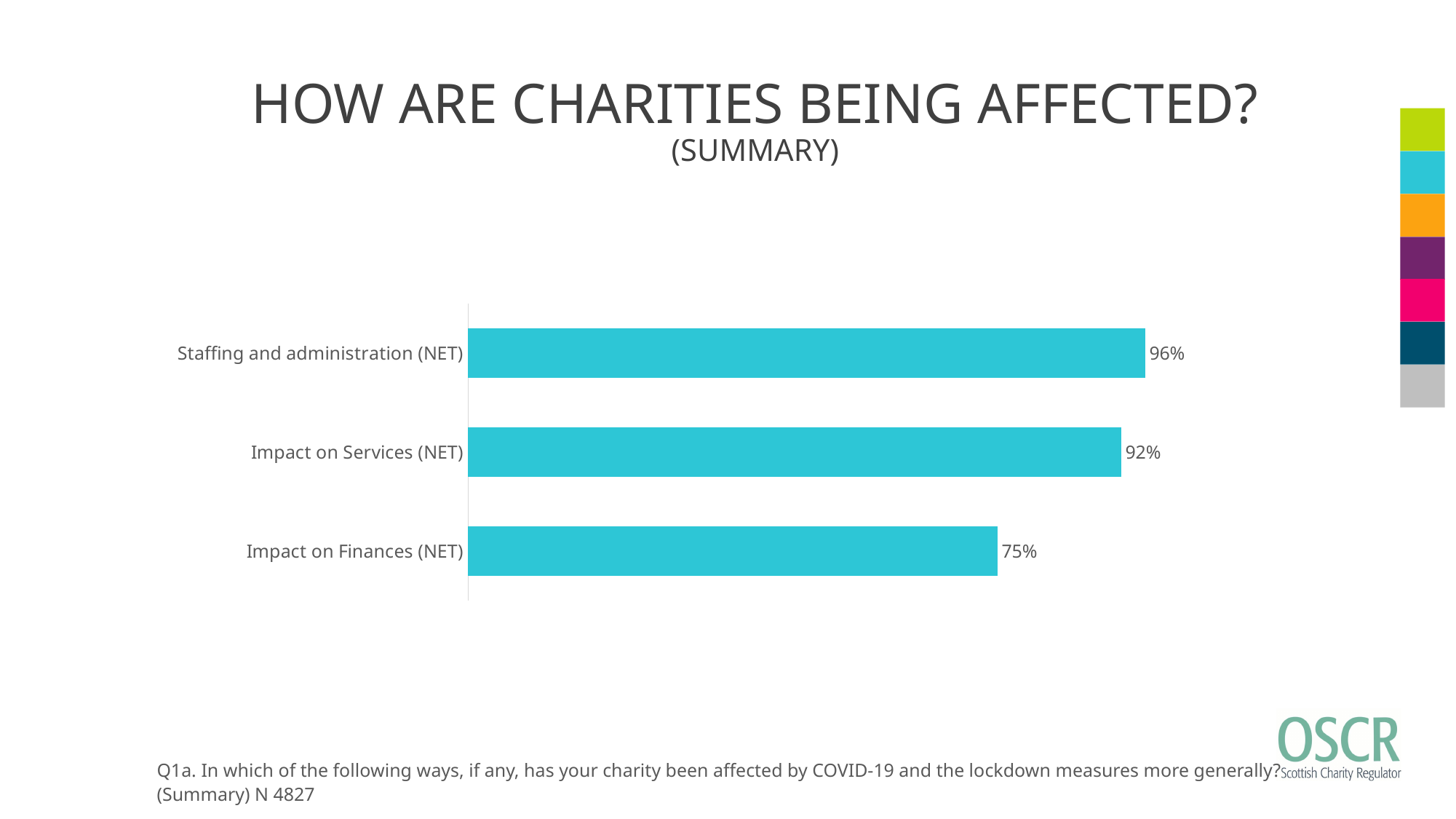
What is the value for Impact on Services (NET)? 92% What is the value for Impact on Finances (NET)? 75% What is the title of the slide containing the chart? HOW ARE CHARITIES BEING AFFECTED? (SUMMARY) How many categories are shown in the chart? 3 Which is larger, the value for Impact on Services (NET) or Impact on Finances (NET)? Impact on Services (NET) What is the value for Staffing and administration (NET)? 96% What is the difference between the values for Staffing and administration (NET) and Impact on Finances (NET)? 21% What is the sample size (N) stated in the footnote below the chart? 4827 What is the difference between the values for Staffing and administration (NET) and Impact on Services (NET)? 4% Which category has the lowest value? Impact on Finances (NET) Which category has the highest value? Staffing and administration (NET) What kind of chart is shown on the slide? Bar chart